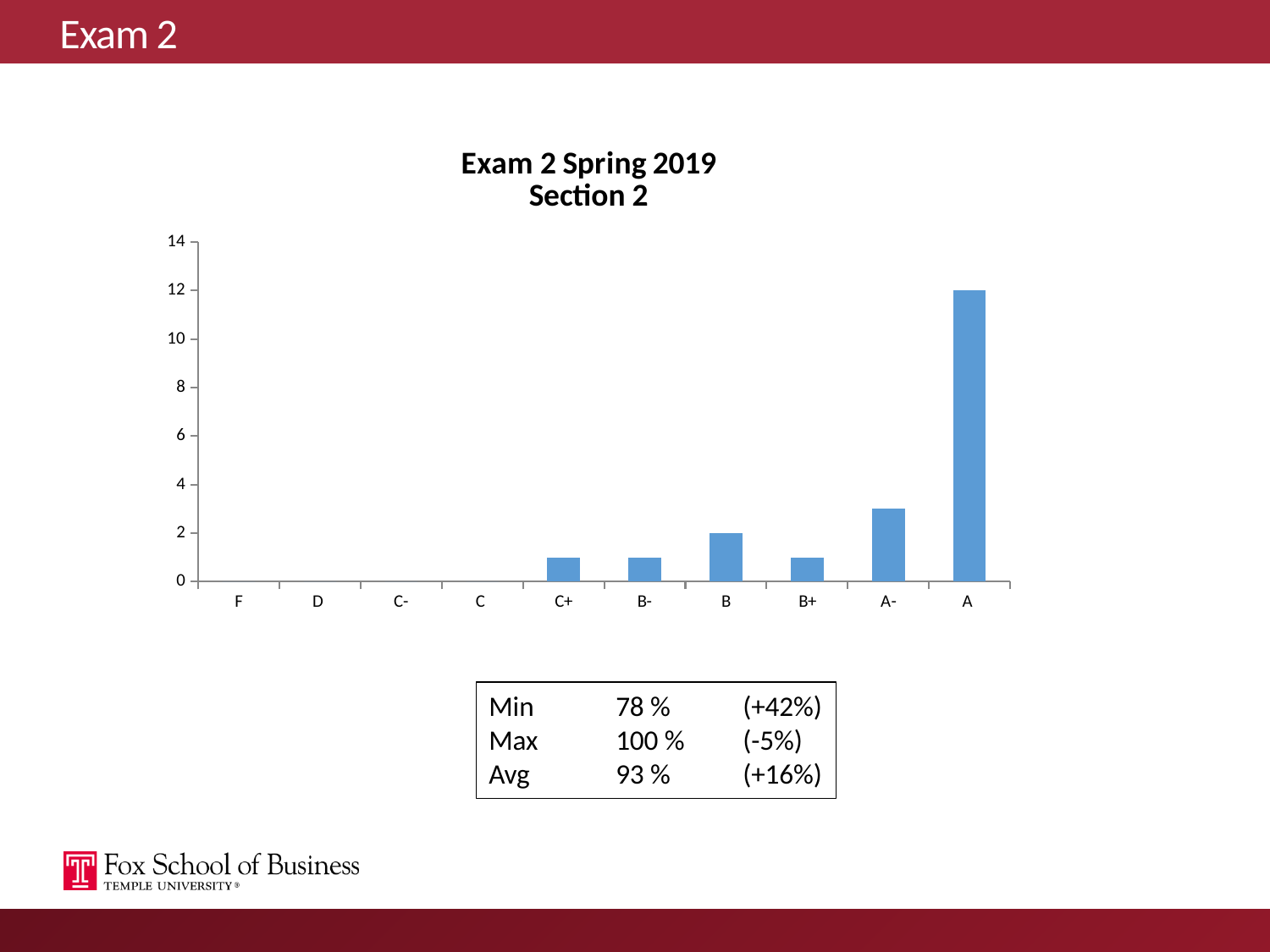
What is the value for grade B? 2 What is the title of the chart? Exam 2 Spring 2019 Section 2 Which grade category has the highest bar? A What is the value for grade F? 0 Is the value for C+ greater or less than 2? less What type of chart is shown on the slide? bar chart What is the value for grade A? 12 Do the values generally rise or fall moving from F to A along the x axis? rise How many grade categories are shown on the x axis? 10 Which is larger, the value for A or the value for A-? A What is the difference between the values for A and B? 10 Is the value for A- greater or less than 4? less